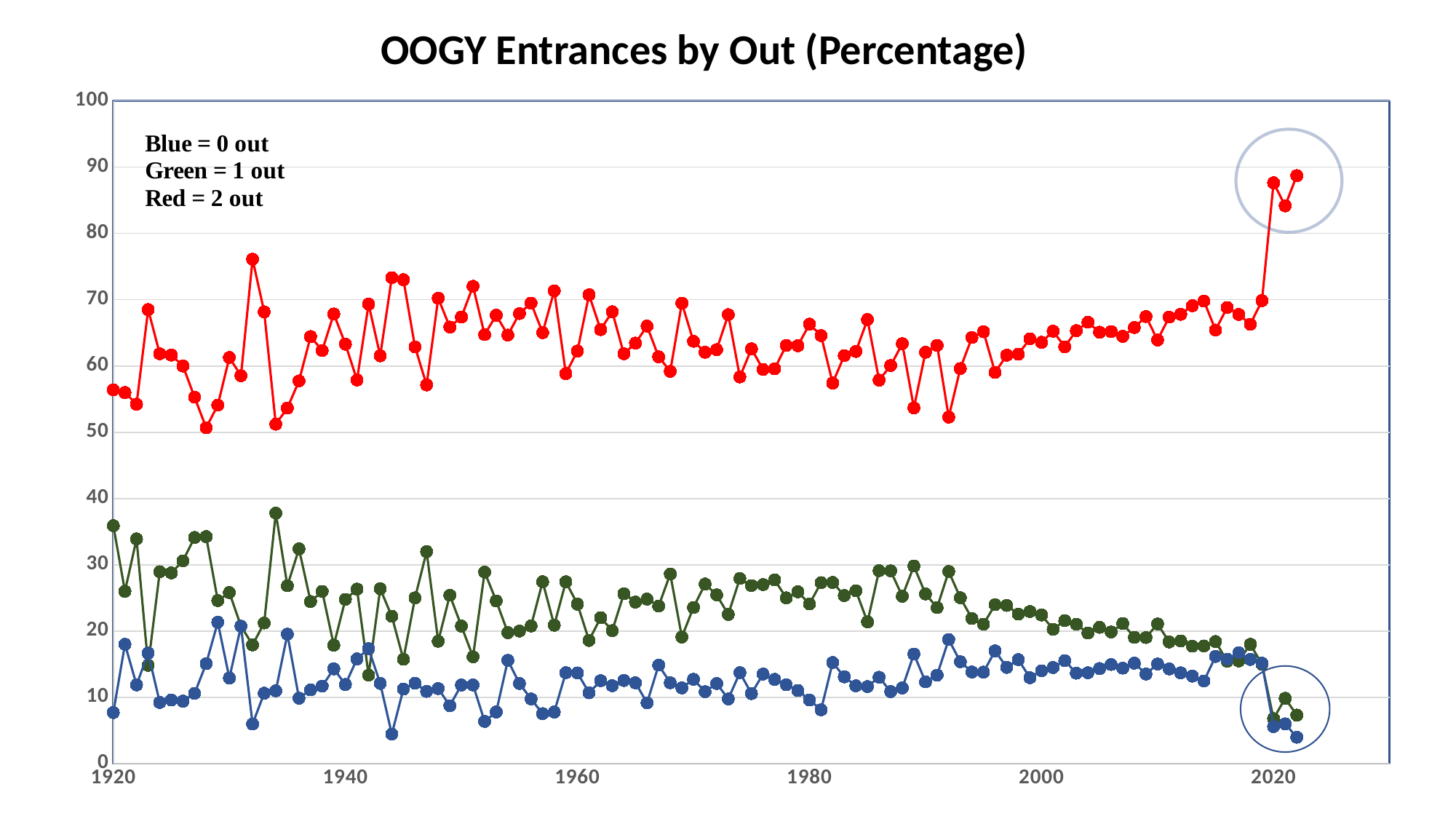
Is the red series value at 1920 greater or less than 50? greater Is the blue series value at 2020 greater or less than 10? less Does the green series rise or fall between 2000 and 2020? fall Is the blue series value at 1920 greater or less than 10? less How many series does the chart's legend text list? 3 According to the legend text, what does the red series represent? 2 out Which series has the highest values across the whole chart? Red (2 out) What kind of chart is shown on the slide? line chart At 2020, which is higher: the red series or the green series? red series What is the title of the chart? OOGY Entrances by Out (Percentage)